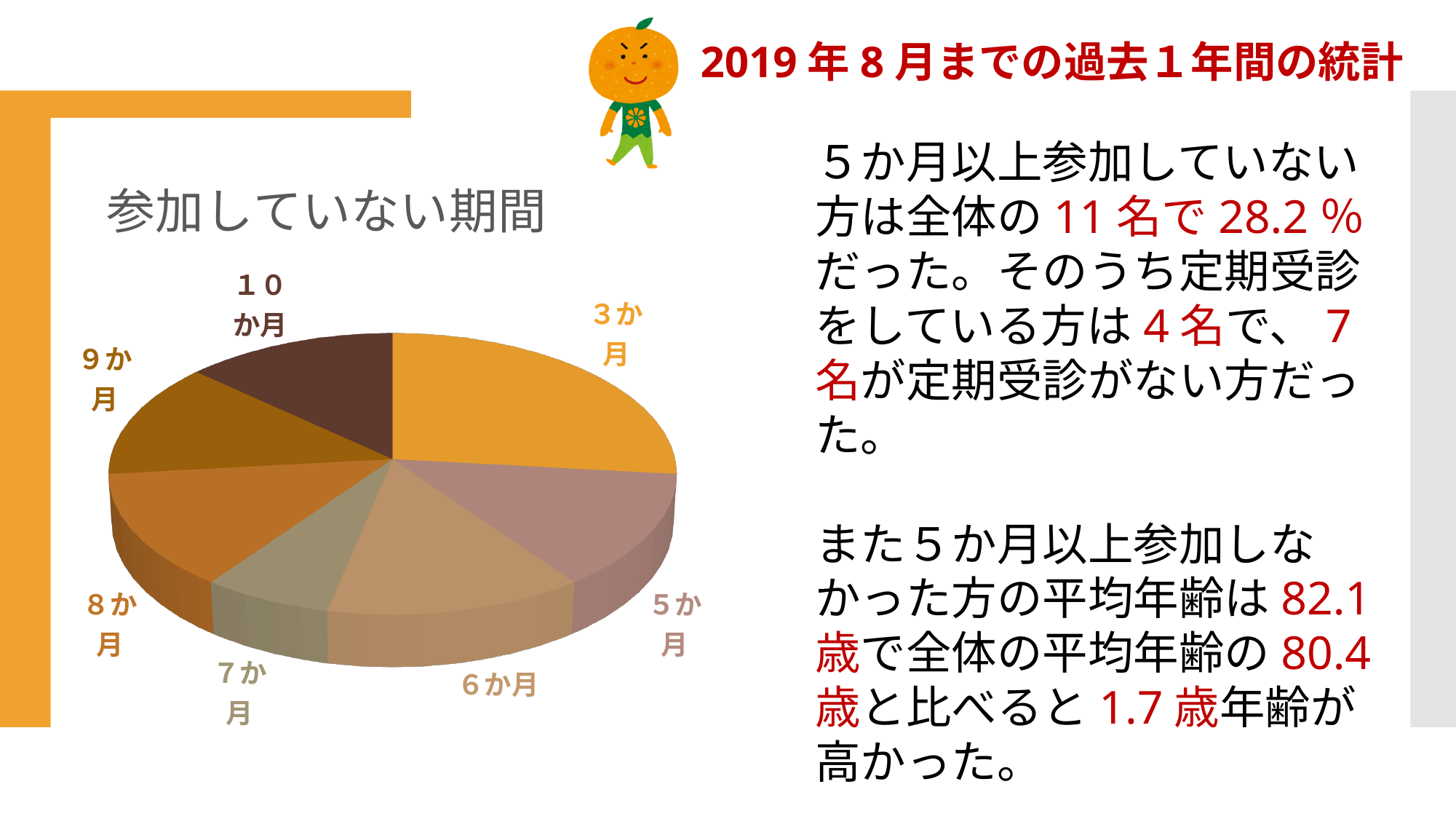
Which category label appears at the top of the pie chart, between 9か月 and 3か月? 10か月 How many slices (categories) does the pie chart have? 7 Which category has the largest slice in the pie chart? 3か月 What is the title of the pie chart? 参加していない期間 Which slice is larger, 3か月 or 5か月? 3か月 Which slice is larger, 6か月 or 7か月? 6か月 What colour is the 3か月 slice of the pie chart? orange What kind of chart is shown on the slide? pie chart Which slice is larger, 3か月 or 7か月? 3か月